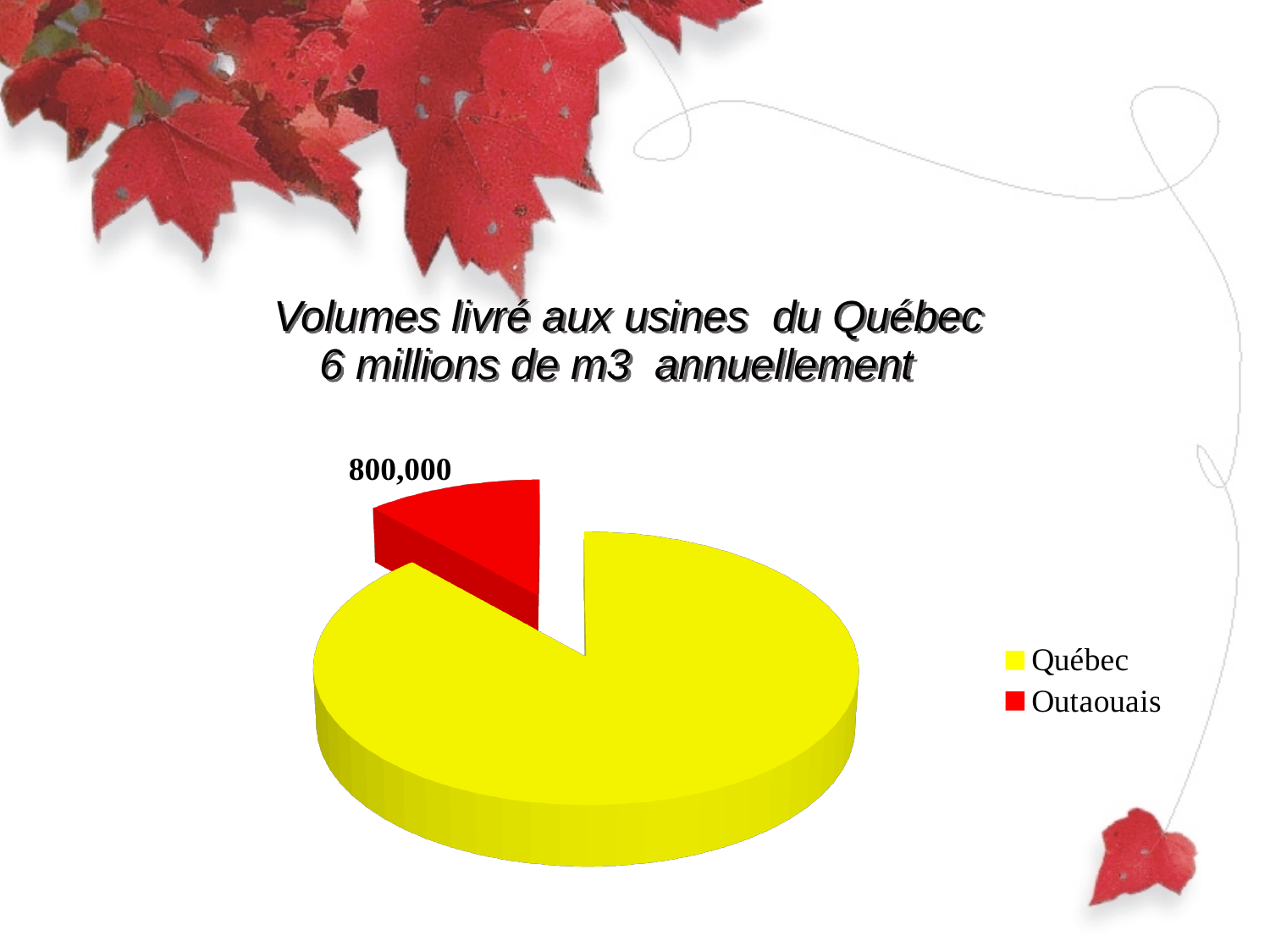
Which category has the largest slice of the pie? Québec Which category has the smallest slice of the pie? Outaouais How many entries does the legend list? 2 What kind of chart is shown on the slide? pie chart Which is larger, the Québec slice or the Outaouais slice? Québec What colour is the Outaouais slice? red How many slices does the pie chart have? 2 What value is labelled on the Outaouais slice? 800,000 What is the title shown above the chart? Volumes livré aux usines du Québec 6 millions de m3 annuellement